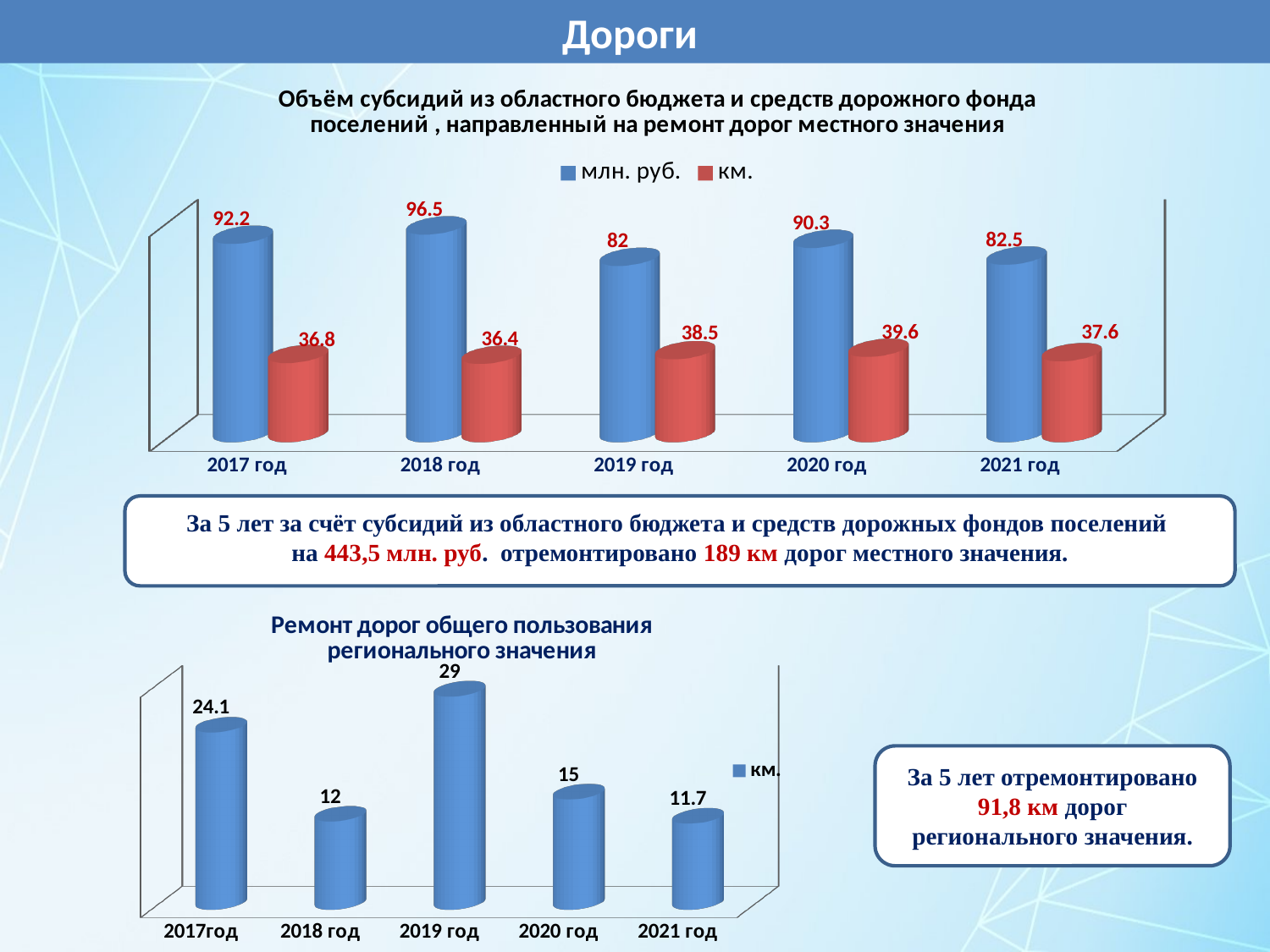
In the bottom chart (Ремонт дорог общего пользования регионального значения), what is the value for 2019 год? 29 In the top chart, what is the value in млн. руб. for 2018 год? 96.5 In the top chart, what is the difference between the млн. руб. values for 2017 год and 2019 год? 10.2 In the bottom chart (Ремонт дорог общего пользования регионального значения), what is the difference between the values for 2017год and 2018 год? 12.1 How many series does the legend of the top chart list? 2 In the top chart, which is larger: the км value for 2019 год or for 2021 год? 2019 год In the bottom chart (Ремонт дорог общего пользования регионального значения), which year has the lowest value? 2021 год In the top chart, what is the value in км for 2020 год? 39.6 How many years are shown on the x axis of the top chart? 5 In the top chart, which year has the lowest value in км? 2018 год What kind of chart is the bottom chart (Ремонт дорог общего пользования регионального значения)? Bar chart In the top chart, which year has the highest value in млн. руб.? 2018 год